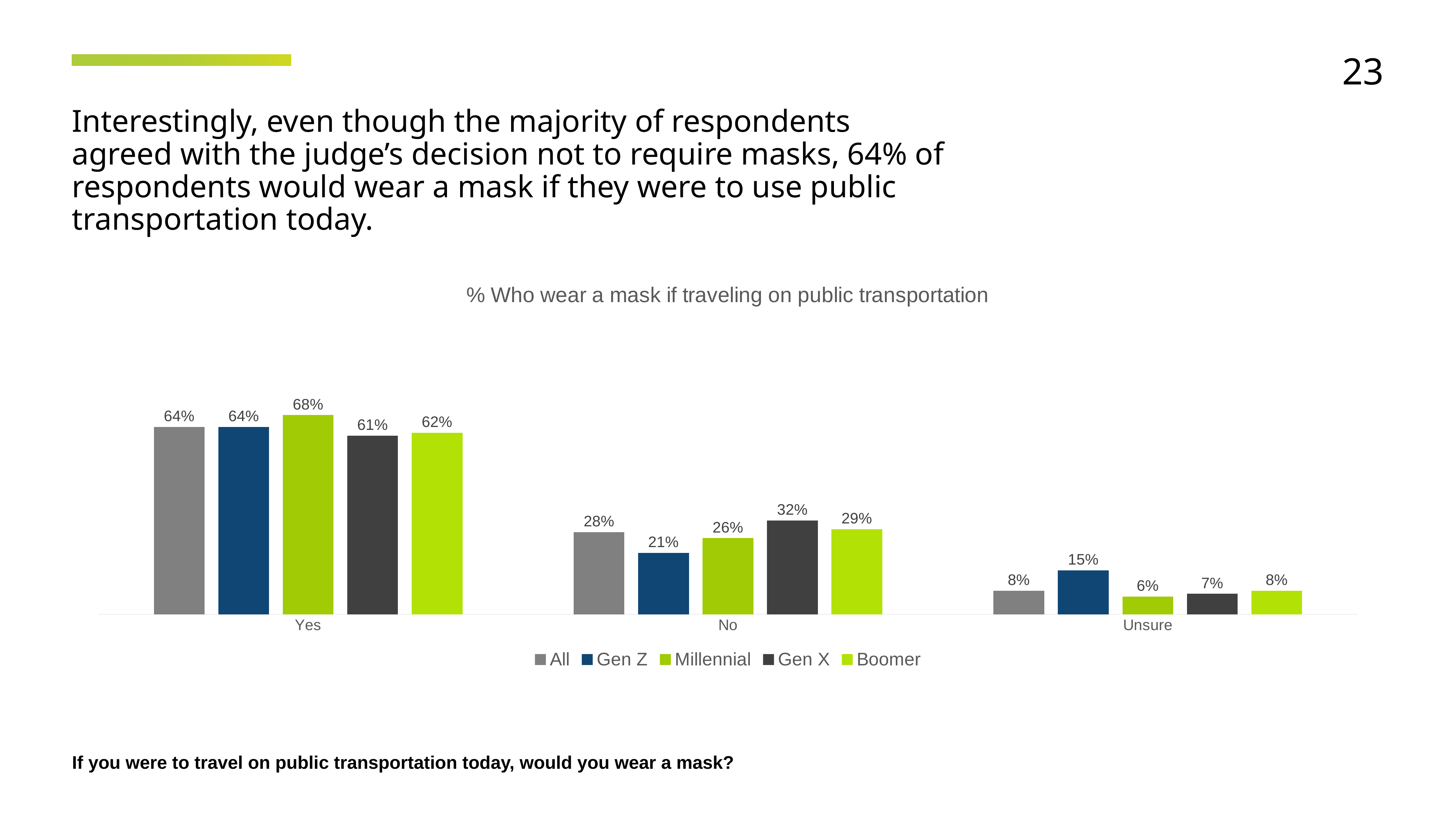
Which series has the lowest value in the Unsure category? Millennial What is the title of the chart? % Who wear a mask if traveling on public transportation What is the difference between the Gen X and Gen Z values in the No category? 11% How many response categories are shown on the x axis? 3 What is the value for Gen X in the No category? 32% How many series does the legend list? 5 What is the value for Gen Z in the Unsure category? 15% What kind of chart is shown on the slide? Bar chart What percentage of Millennials would wear a mask if traveling on public transportation (Yes)? 68% What is the value for All in the No category? 28% Which is larger in the Yes category: the value for Gen X or the value for Boomer? Boomer Which series has the highest value in the Yes category? Millennial